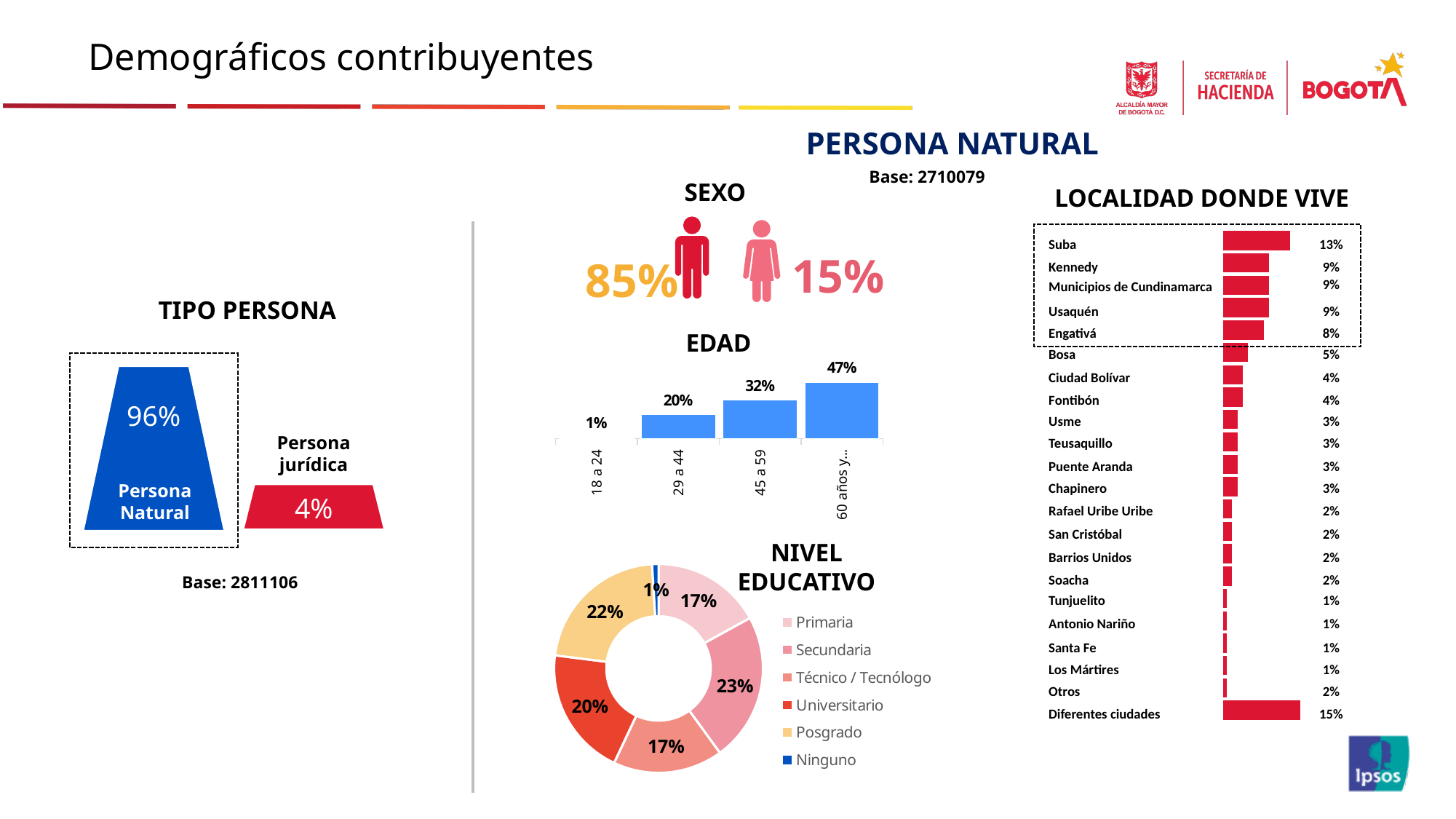
In the NIVEL EDUCATIVO chart, what share does Secundaria have? 23% In the LOCALIDAD DONDE VIVE chart, how many categories are plotted? 22 In the LOCALIDAD DONDE VIVE chart, which category has the highest value? Diferentes ciudades In the NIVEL EDUCATIVO chart, which category has the smallest share? Ninguno In the EDAD chart, do the values rise or fall from left to right along the x axis? rise In the EDAD chart, which age group has the highest value? 60 años y... In the LOCALIDAD DONDE VIVE chart, what is the value for Suba? 13% How many entries does the legend of the NIVEL EDUCATIVO chart list? 6 In the EDAD chart, what is the difference between the 60 años y... group and the 29 a 44 group? 27 percentage points In the EDAD chart, what is the value for the 45 a 59 age group? 32% In the LOCALIDAD DONDE VIVE chart, which is larger, Bosa or Usme? Bosa What kind of chart is the NIVEL EDUCATIVO chart? donut chart